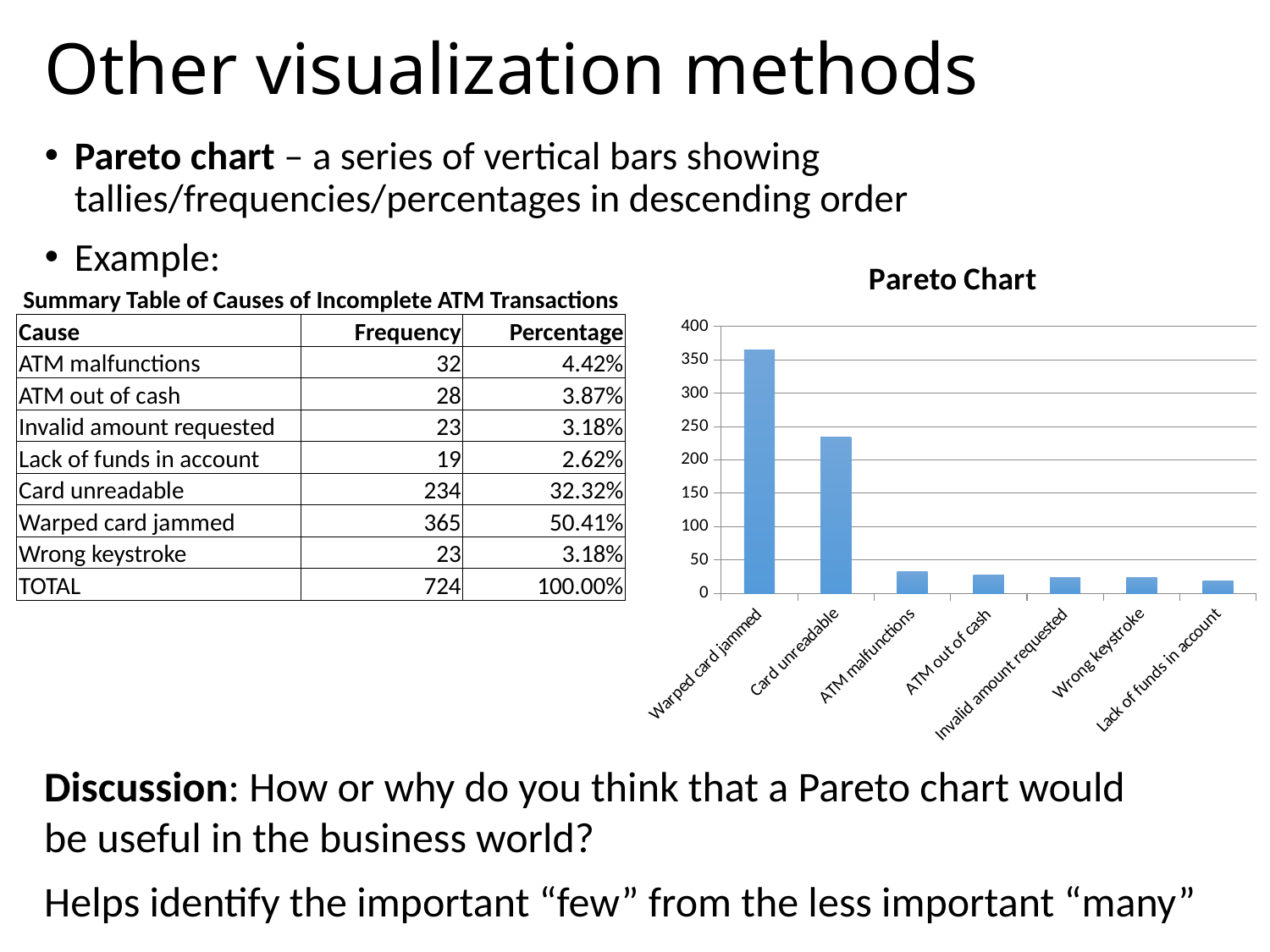
Is the value for Warped card jammed in the Pareto Chart greater or less than 350? greater Is the value for ATM malfunctions in the Pareto Chart greater or less than 50? less Which category has the highest bar in the Pareto Chart? Warped card jammed What is the title of the chart on the slide? Pareto Chart What is the frequency for Card unreadable shown in the Pareto Chart? 234 In the Pareto Chart, which is larger: Card unreadable or ATM malfunctions? Card unreadable What is the frequency for Warped card jammed shown in the Pareto Chart? 365 Do the bar values in the Pareto Chart rise or fall from left to right? fall What is the difference between the frequencies of Warped card jammed and Card unreadable in the Pareto Chart? 131 How many bars (categories) does the Pareto Chart show? 7 Which category has the lowest bar in the Pareto Chart? Lack of funds in account What kind of chart is the Pareto Chart on the slide? bar chart